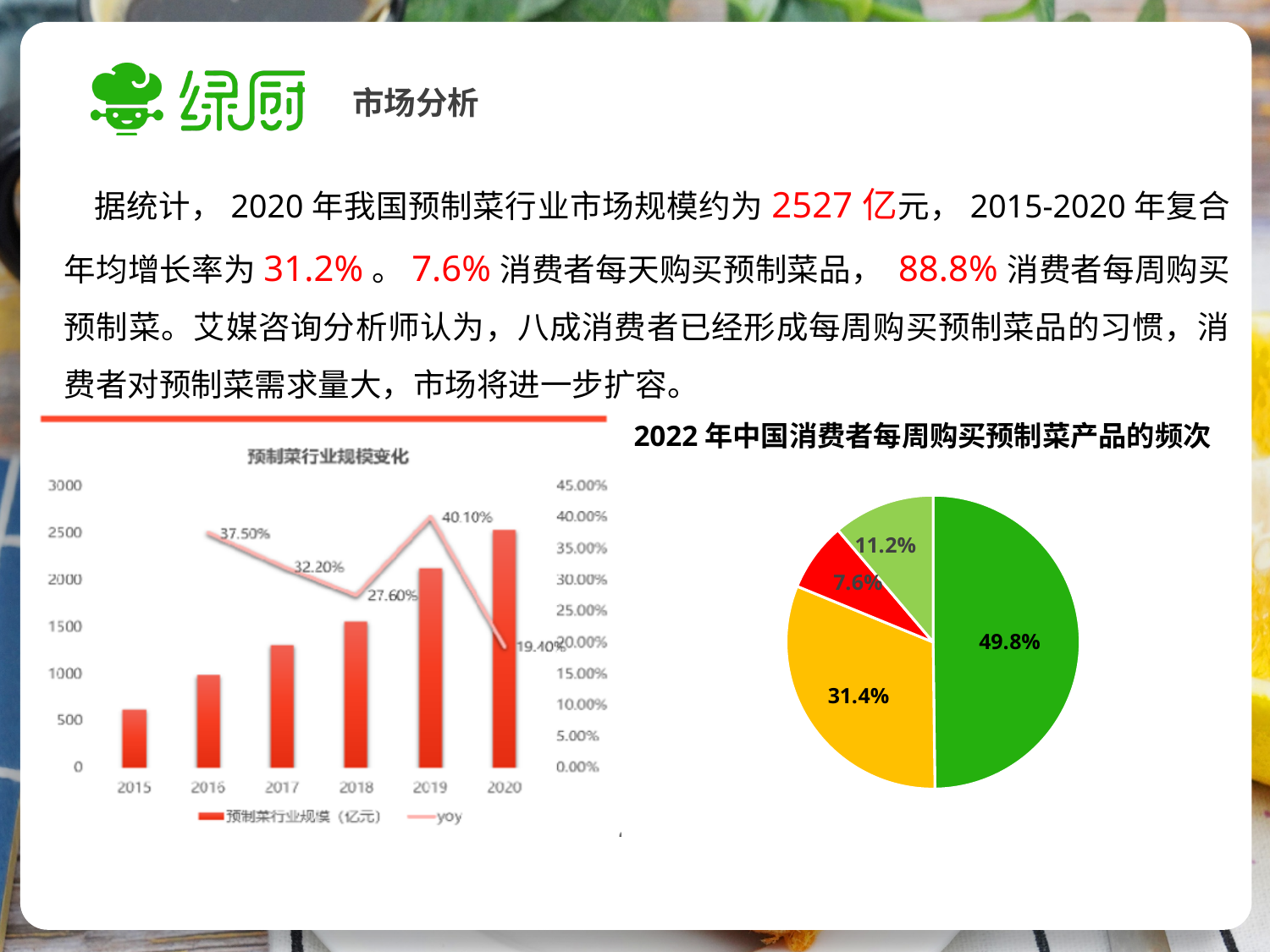
In the pie chart titled 2022年中国消费者每周购买预制菜产品的频次, what is the share of the largest slice? 49.8% In the chart titled 预制菜行业规模变化, which year has the lowest yoy value? 2020 In the chart titled 预制菜行业规模变化, which year has the highest yoy value? 2019 In the chart titled 预制菜行业规模变化, is the bar value for 2020 greater or less than 2000? greater In the chart titled 预制菜行业规模变化, what is the yoy value for 2016? 37.50% In the chart titled 预制菜行业规模变化, do the bar values rise or fall from 2015 to 2020? rise In the chart titled 预制菜行业规模变化, is the bar value for 2015 greater or less than 1000? less In the chart titled 预制菜行业规模变化, what is the yoy value for 2019? 40.10% In the chart titled 预制菜行业规模变化, how many years are shown on the x axis? 6 In the pie chart titled 2022年中国消费者每周购买预制菜产品的频次, what is the difference between the two largest slices? 18.4 percentage points In the chart titled 预制菜行业规模变化, how many series does the legend list? 2 In the chart titled 预制菜行业规模变化, what is the difference between the yoy values for 2019 and 2020? 20.70 percentage points